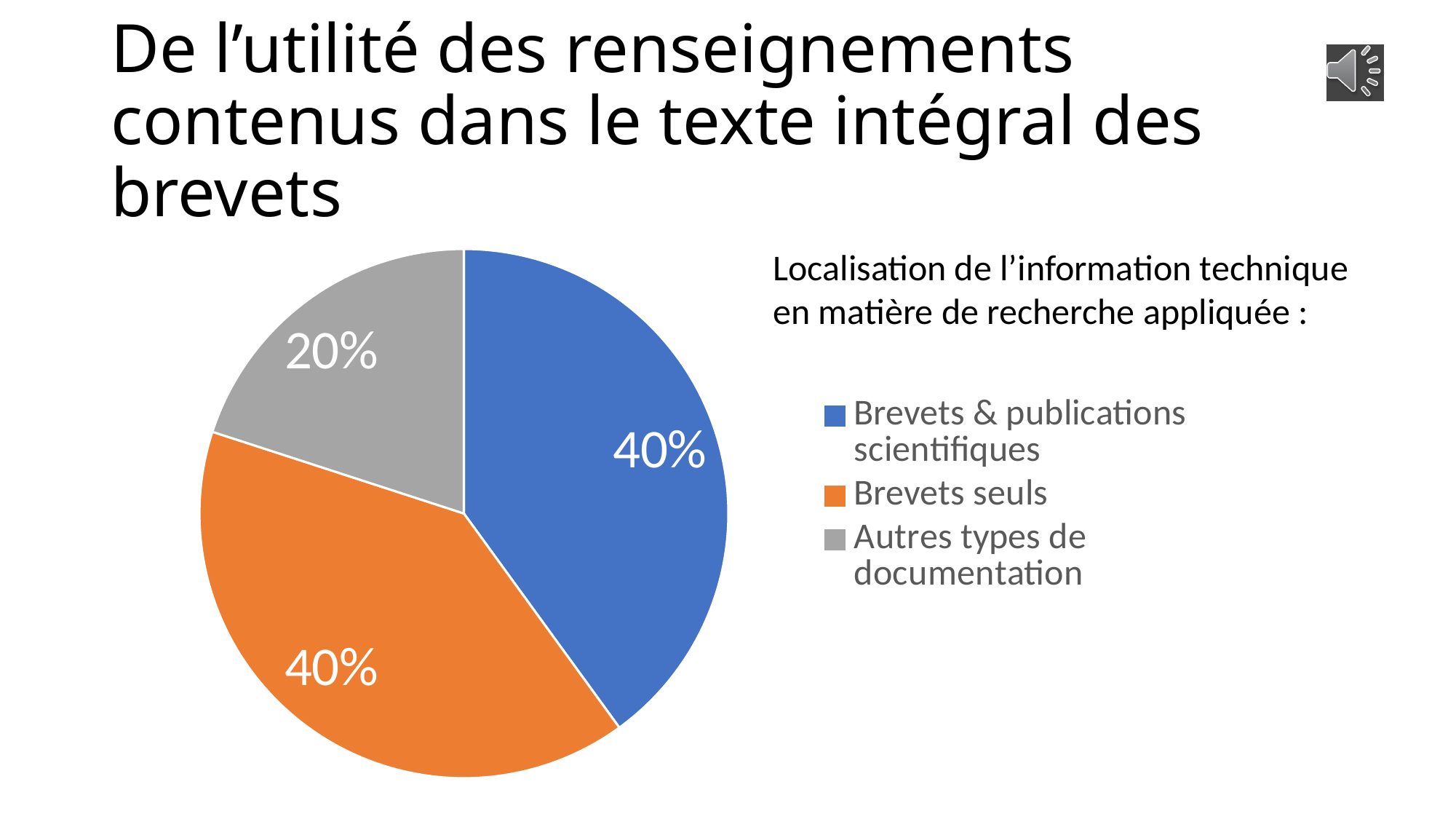
Which colour is used for the "Brevets seuls" slice? orange Which is larger: the share for "Brevets seuls" or the share for "Autres types de documentation"? Brevets seuls Which category has the smallest slice of the pie? Autres types de documentation What share of the pie does "Brevets & publications scientifiques" represent? 40% What share of the pie does "Brevets seuls" represent? 40% What share of the pie does "Autres types de documentation" represent? 20% How many entries does the legend list? 3 What kind of chart is shown on the slide? pie chart How many slices does the pie chart have? 3 What is the text above the legend describing the chart? Localisation de l’information technique en matière de recherche appliquée : What is the difference between the share for "Brevets seuls" and the share for "Autres types de documentation"? 20%